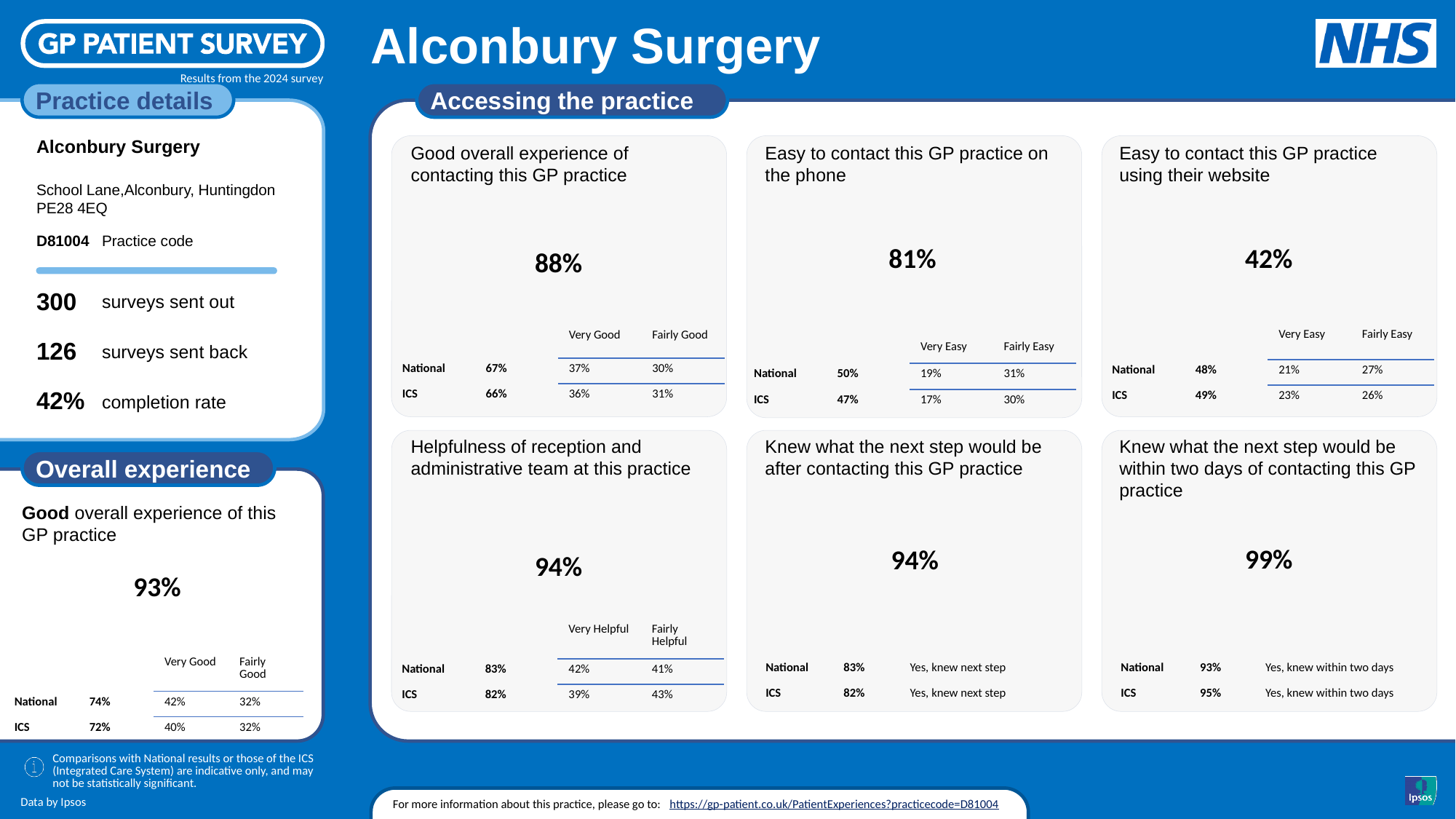
Across the six 'Accessing the practice' panels, which measure has the highest headline percentage? Knew what the next step would be within two days of contacting this GP practice In the 'Good overall experience of this GP practice' panel, which is larger, the National value or the ICS value? National In the 'Knew what the next step would be within two days of contacting this GP practice' panel, what is the ICS value? 95% How many panels are shown under the 'Accessing the practice' heading? 6 In the 'Good overall experience of this GP practice' panel under Overall experience, what is the practice's headline percentage? 93% In the 'Helpfulness of reception and administrative team at this practice' panel, what is the National 'Fairly Helpful' value? 41% In the 'Easy to contact this GP practice using their website' panel, what is the ICS 'Very Easy' value? 23% In the 'Knew what the next step would be after contacting this GP practice' panel, what is the difference between the National and ICS values? 1% In the 'Easy to contact this GP practice on the phone' panel, what is the difference between the practice's headline value and the National value? 31% In the 'Easy to contact this GP practice on the phone' panel, what is the National value? 50% In the 'Good overall experience of contacting this GP practice' panel, what is the practice's headline percentage? 88% Across the six 'Accessing the practice' panels, which measure has the lowest headline percentage? Easy to contact this GP practice using their website